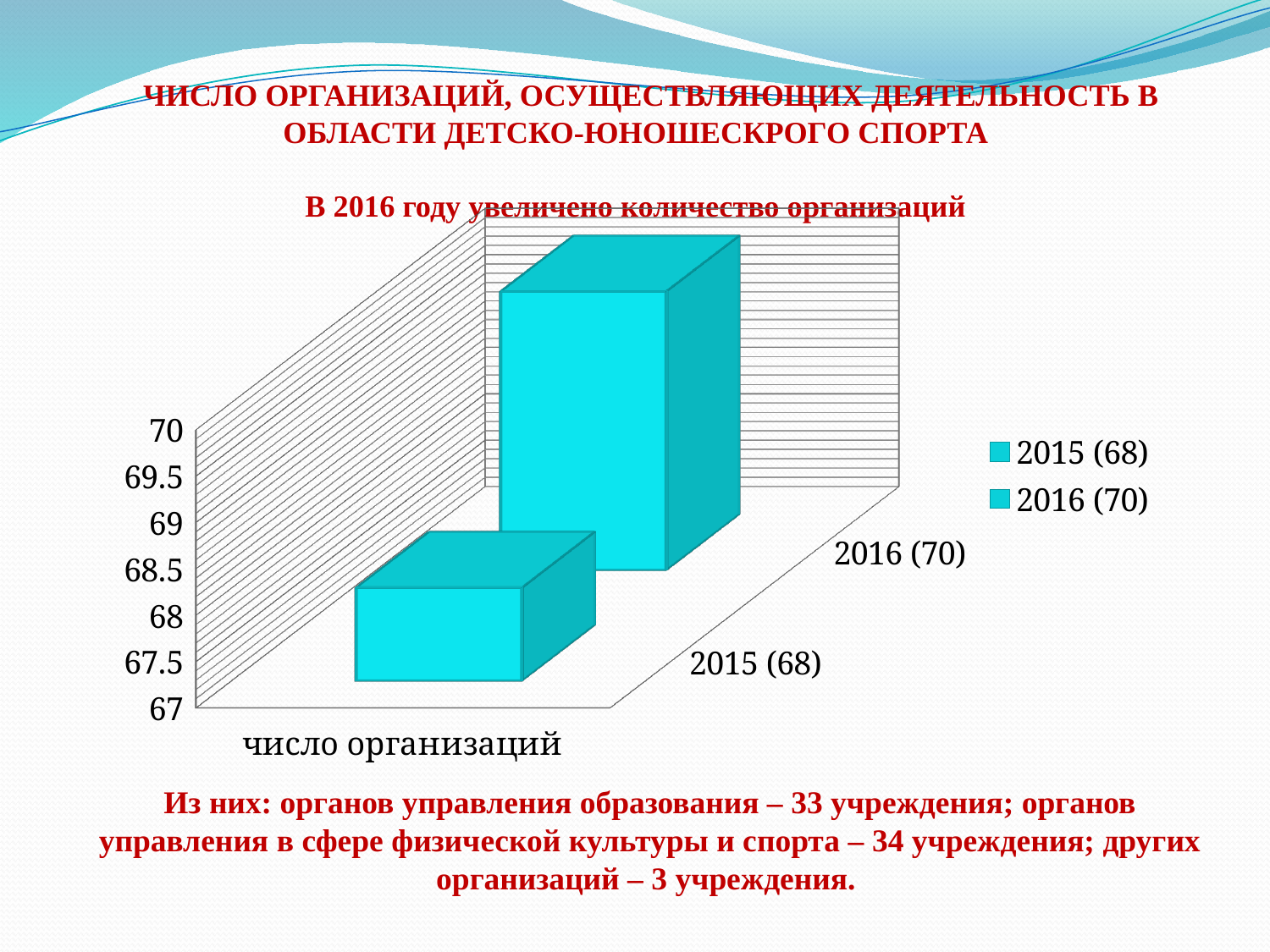
Which series has the lower value, 2015 or 2016? 2015 Is the value for 2015 greater or less than 69? less How many series does the chart legend list? 2 What is the value for the series 2015 (68)? 68 What is the label on the category axis of the chart? число организаций Do the values rise or fall from 2015 to 2016? rise Which series has the higher value, 2015 or 2016? 2016 What kind of chart is shown on the slide? bar chart What is the value for the series 2016 (70)? 70 What is the lowest value shown on the vertical axis of the chart? 67 What is the difference between the 2016 value and the 2015 value? 2 Is the value for 2016 greater or less than 69? greater